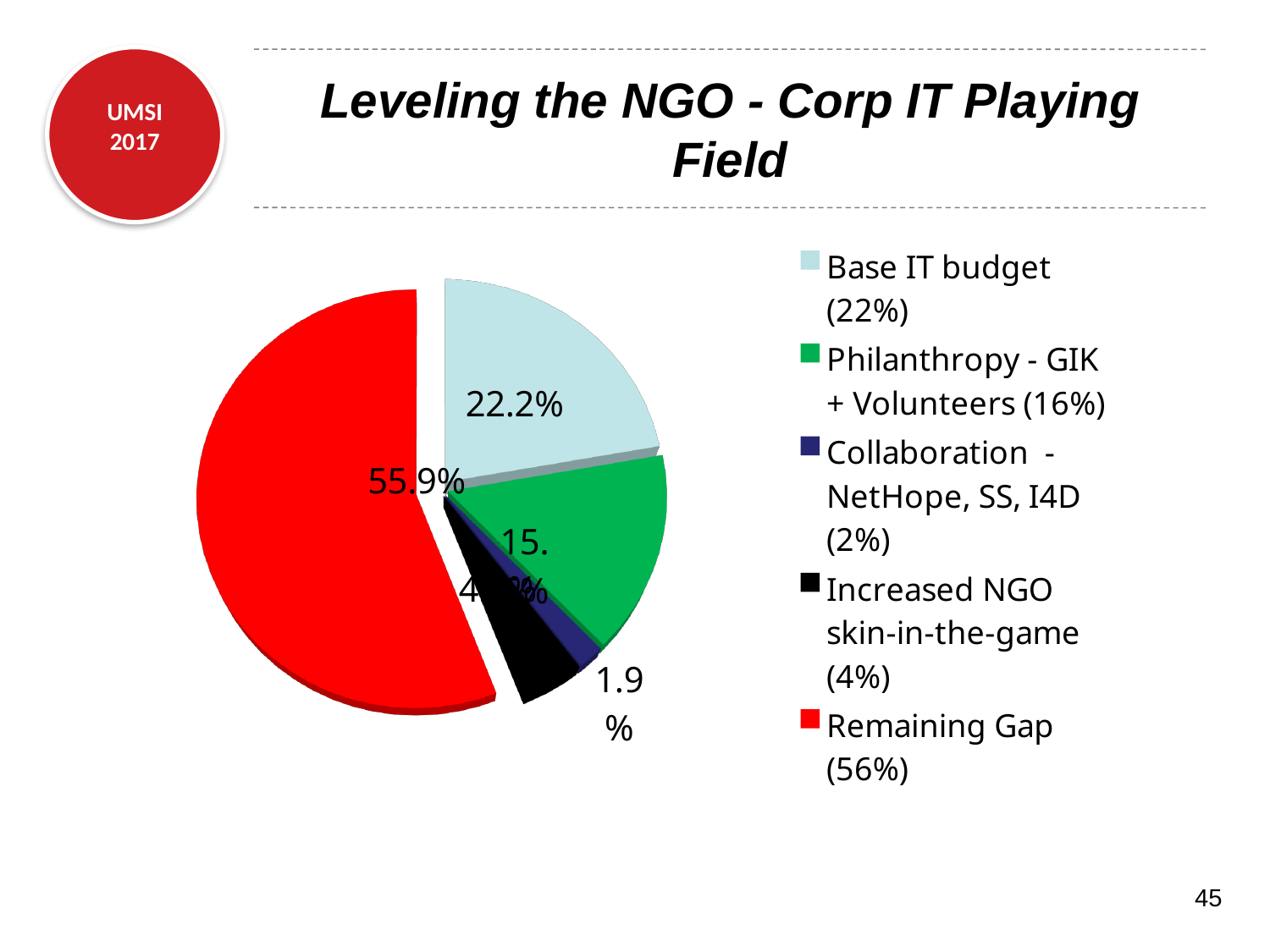
Which slice is larger: Base IT budget or Philanthropy - GIK + Volunteers? Base IT budget What is the difference between the Remaining Gap data label and the Base IT budget data label? 33.7 percentage points What is the data label shown on the Base IT budget slice? 22.2% Which slice is larger: Increased NGO skin-in-the-game or Collaboration - NetHope, SS, I4D? Increased NGO skin-in-the-game Which category has the smallest slice of the pie? Collaboration - NetHope, SS, I4D What kind of chart is shown on the slide? Pie chart What is the data label shown on the Remaining Gap slice? 55.9% How many slices does the pie chart have? 5 Which category has the largest slice of the pie? Remaining Gap What is the data label shown on the Collaboration - NetHope, SS, I4D slice? 1.9% What colour is the Remaining Gap slice? Red What percentage does the legend give for Philanthropy - GIK + Volunteers? 16%